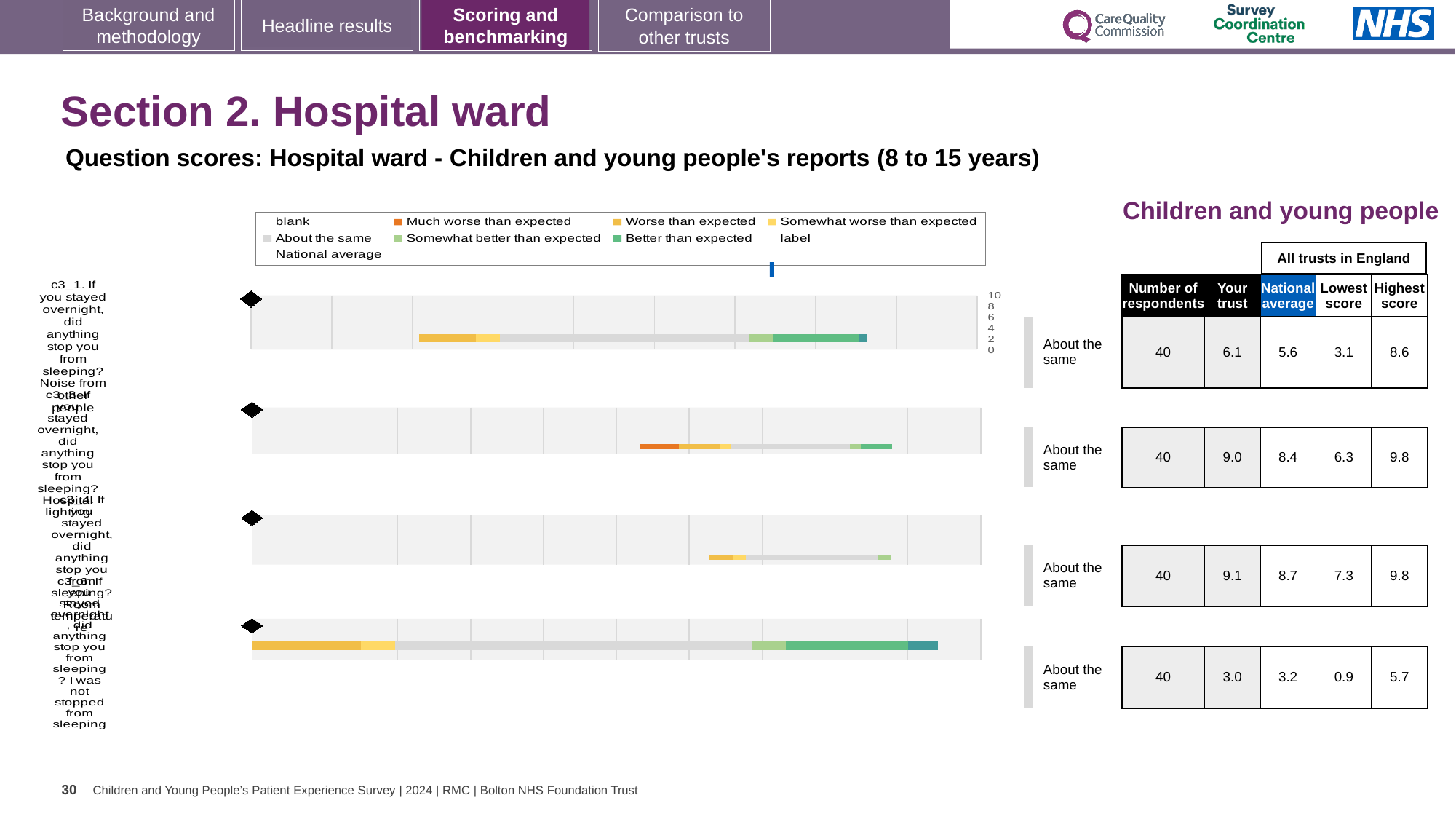
For the top chart (c3_1), which is larger: the 'Your trust' score or the national average? Your trust How many separate question bar charts are shown on the slide? 4 For the top chart (c3_1, noise from other people), what is the national average shown in the table? 5.6 For the bottom chart (c3_6), what is the lowest score among all trusts in England? 0.9 What kind of chart is used to show the question scores on this slide? bar chart How many respondents are listed for each of the four question charts? 40 For the top chart (c3_1), what is the difference between the 'Your trust' score (6.1) and the national average (5.6)? 0.5 In the chart legend, which colour represents 'Much worse than expected'? orange For the top chart (c3_1, noise from other people), what is the 'Your trust' score shown in the table? 6.1 What benchmark category is given for all four question charts? About the same For the bottom chart (c3_6, I was not stopped from sleeping), what is the highest score among all trusts in England? 5.7 In the chart legend, which colour represents 'Better than expected'? green